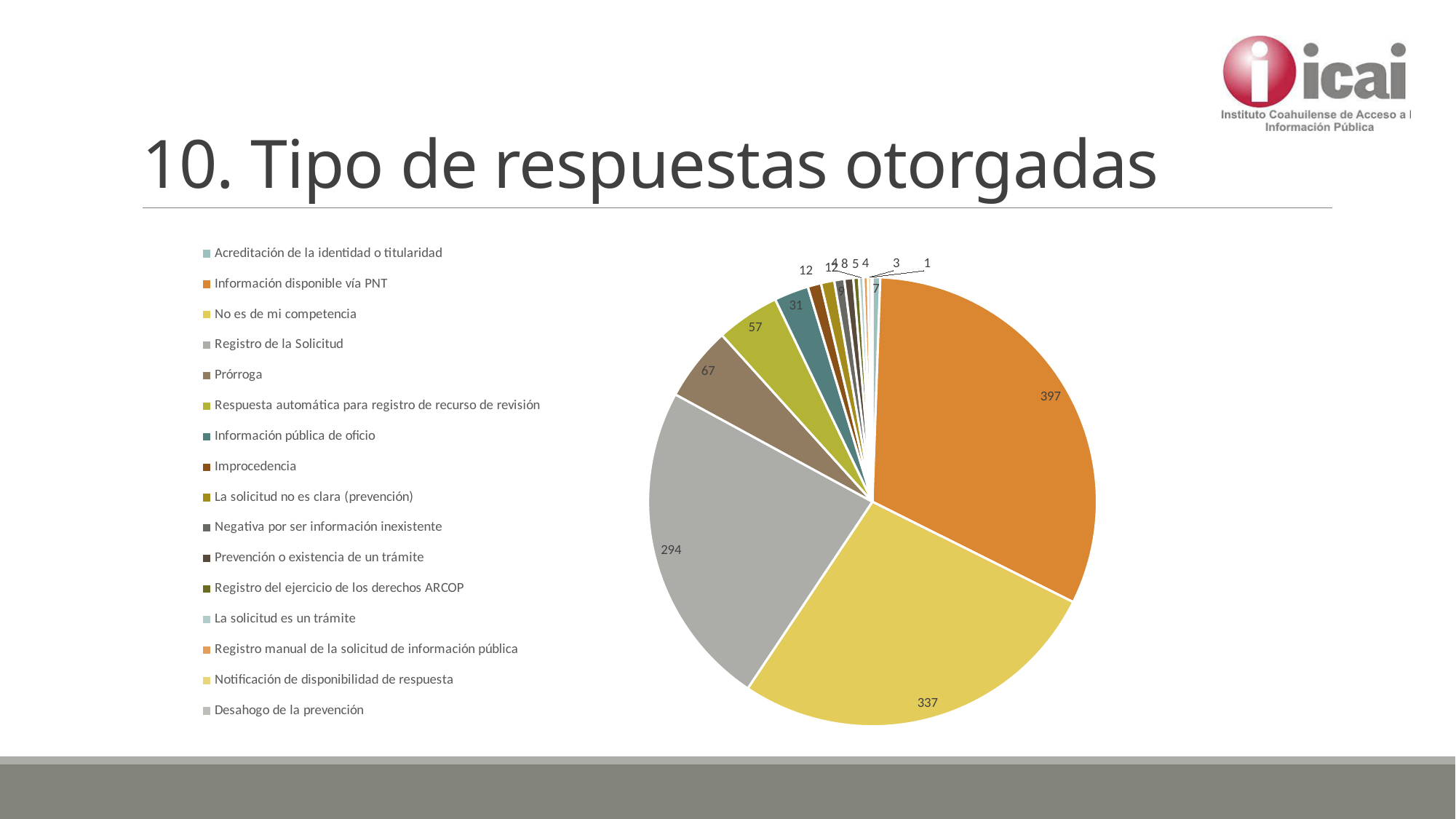
What is the value for 'Información pública de oficio'? 31 How many categories does the legend of the pie chart list? 16 What is the value for 'Registro de la Solicitud'? 294 What is the title of the slide containing the chart? 10. Tipo de respuestas otorgadas Which category has the largest slice of the pie? Información disponible vía PNT What type of chart is shown on the slide? pie chart What is the value for 'Respuesta automática para registro de recurso de revisión'? 57 What is the value for 'Prórroga'? 67 What is the value for 'Información disponible vía PNT'? 397 What is the difference between the values for 'Información disponible vía PNT' and 'No es de mi competencia'? 60 Which is larger, the value for 'Prórroga' or the value for 'Respuesta automática para registro de recurso de revisión'? Prórroga What is the value for 'No es de mi competencia'? 337